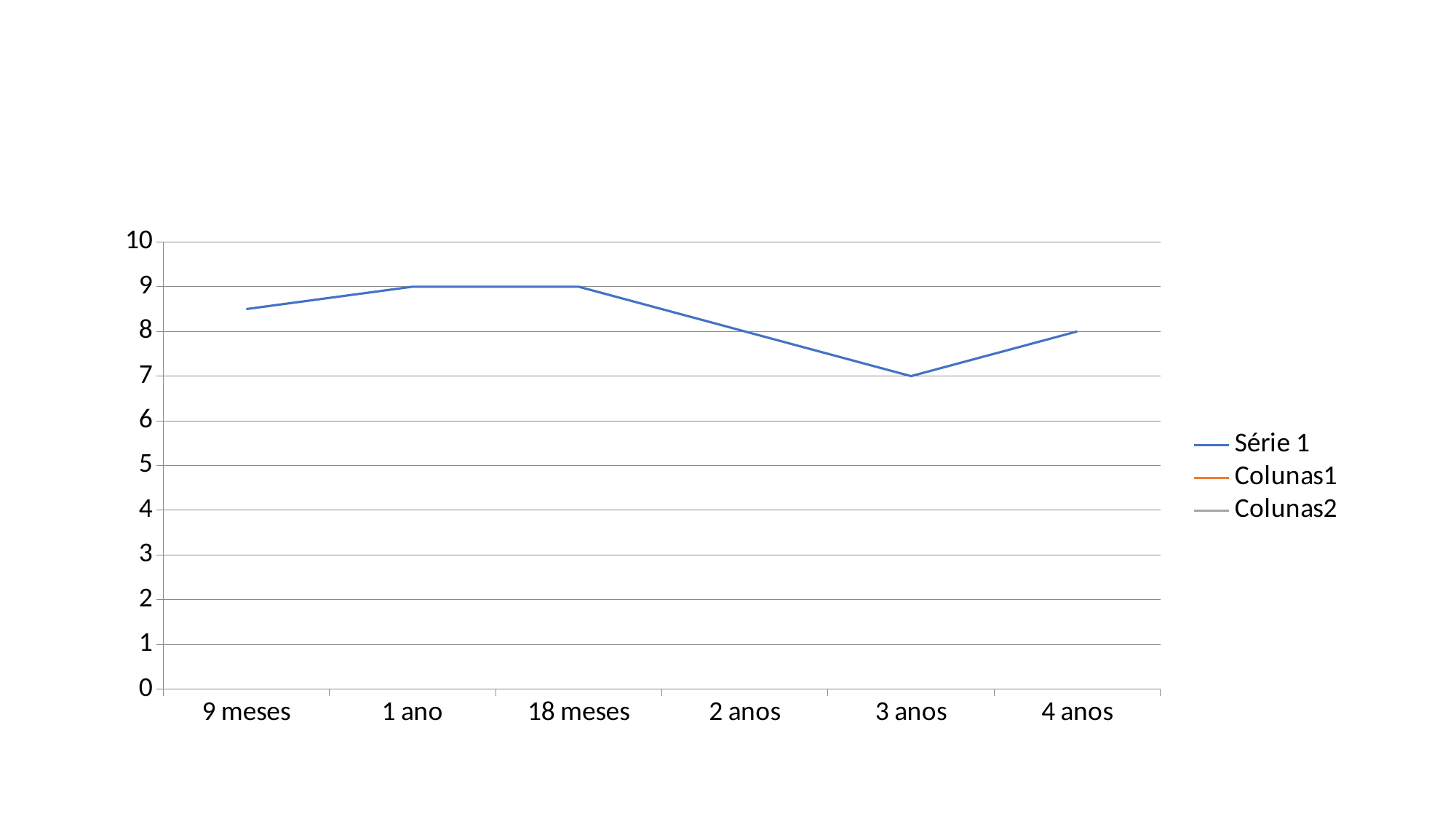
How many categories are shown on the x axis? 6 Which category has the lowest value for Série 1? 3 anos Is the value for 9 meses greater or less than 8? greater What is the value of Série 1 at 1 ano? 9 What is the value of Série 1 at 4 anos? 8 Which is larger, the value at 18 meses or the value at 3 anos? 18 meses What type of chart is shown on the slide? line chart What is the value of Série 1 at 3 anos? 7 Does the line rise or fall from 18 meses to 3 anos? fall What is the difference between the value at 1 ano and the value at 3 anos? 2 How many series does the legend list? 3 What is the value of Série 1 at 18 meses? 9